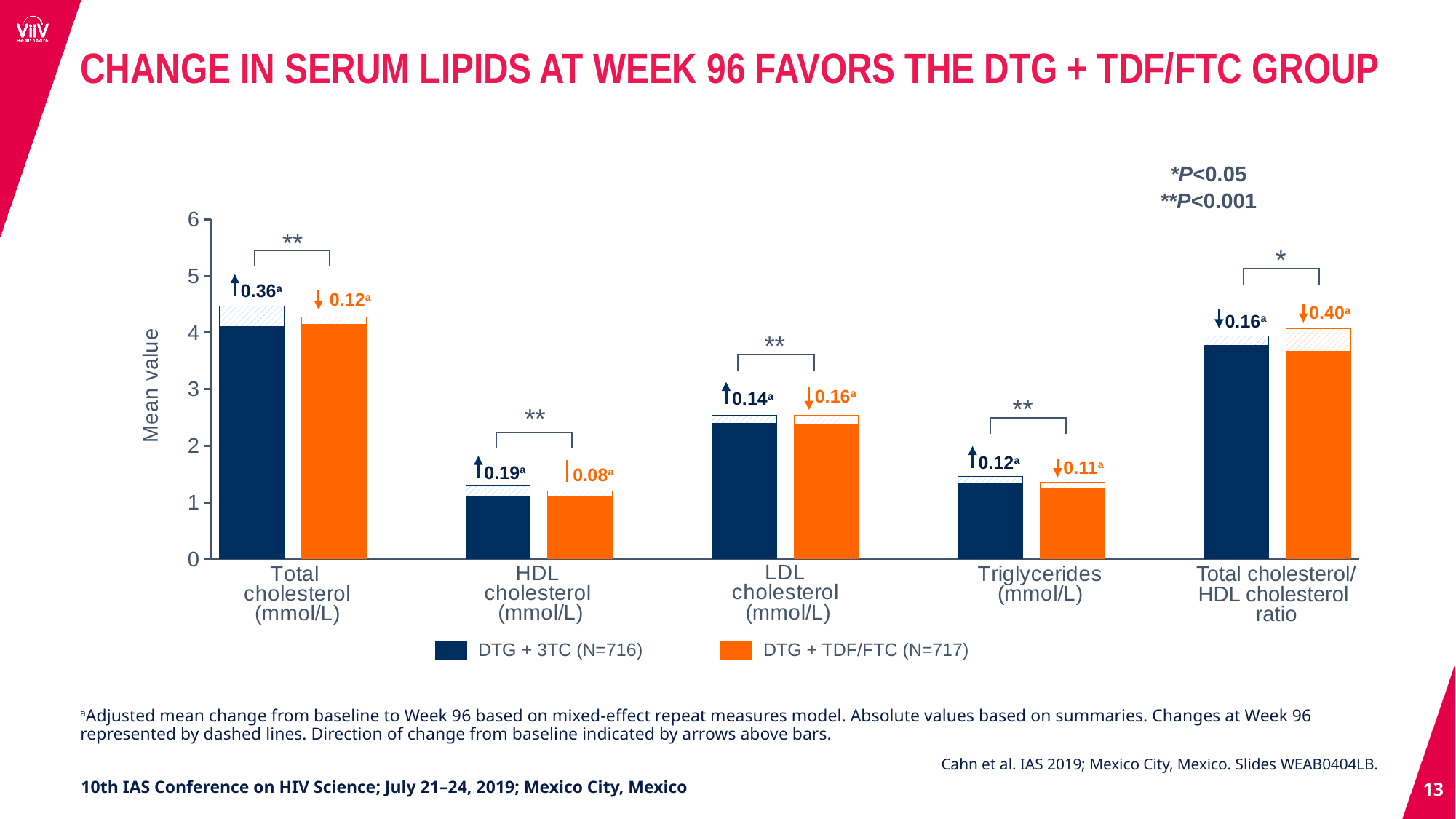
How many lipid categories are shown along the x axis? 5 What change from baseline is labeled above the DTG + 3TC bar for total cholesterol? 0.36 Which category has the highest mean value bars? Total cholesterol (mmol/L) What change from baseline is labeled above the DTG + 3TC bar for triglycerides? 0.12 What kind of chart is shown on the slide? bar chart Is the mean value for DTG + TDF/FTC in triglycerides greater or less than 2? less How many series does the legend list? 2 Which category has the lowest mean value bars? HDL cholesterol (mmol/L) What change from baseline is labeled above the DTG + TDF/FTC bar for LDL cholesterol? 0.16 What is the difference between the labeled changes from baseline for total cholesterol in the DTG + 3TC group (0.36) and the DTG + TDF/FTC group (0.12)? 0.24 What change from baseline is labeled above the DTG + TDF/FTC bar for the total cholesterol/HDL cholesterol ratio? 0.40 Is the mean value for DTG + 3TC in LDL cholesterol greater or less than 2? greater